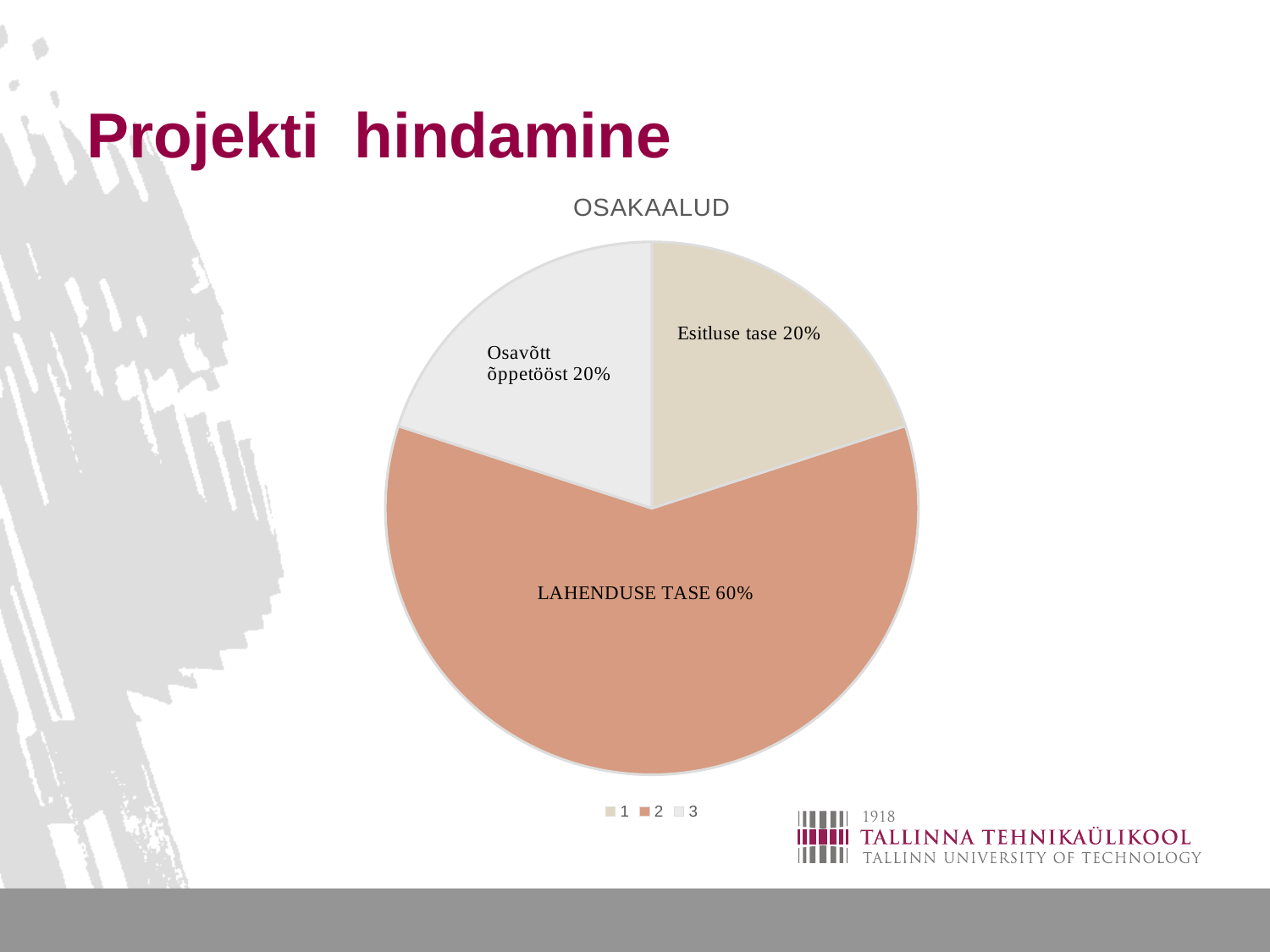
What is the difference between the share for LAHENDUSE TASE and the share for Esitluse tase? 40% Which is larger, the share for LAHENDUSE TASE or the share for Osavõtt õppetööst? LAHENDUSE TASE How many slices does the pie chart have? 3 What is the title of the chart? OSAKAALUD What share of the pie does Esitluse tase take? 20% What kind of chart is shown on the slide? pie chart What are the entries listed in the legend? 1, 2, 3 What share of the pie does LAHENDUSE TASE take? 60% Is the share for LAHENDUSE TASE greater or less than 50%? greater How many entries does the legend list? 3 Which slice of the pie is the largest? LAHENDUSE TASE What share of the pie does Osavõtt õppetööst take? 20%